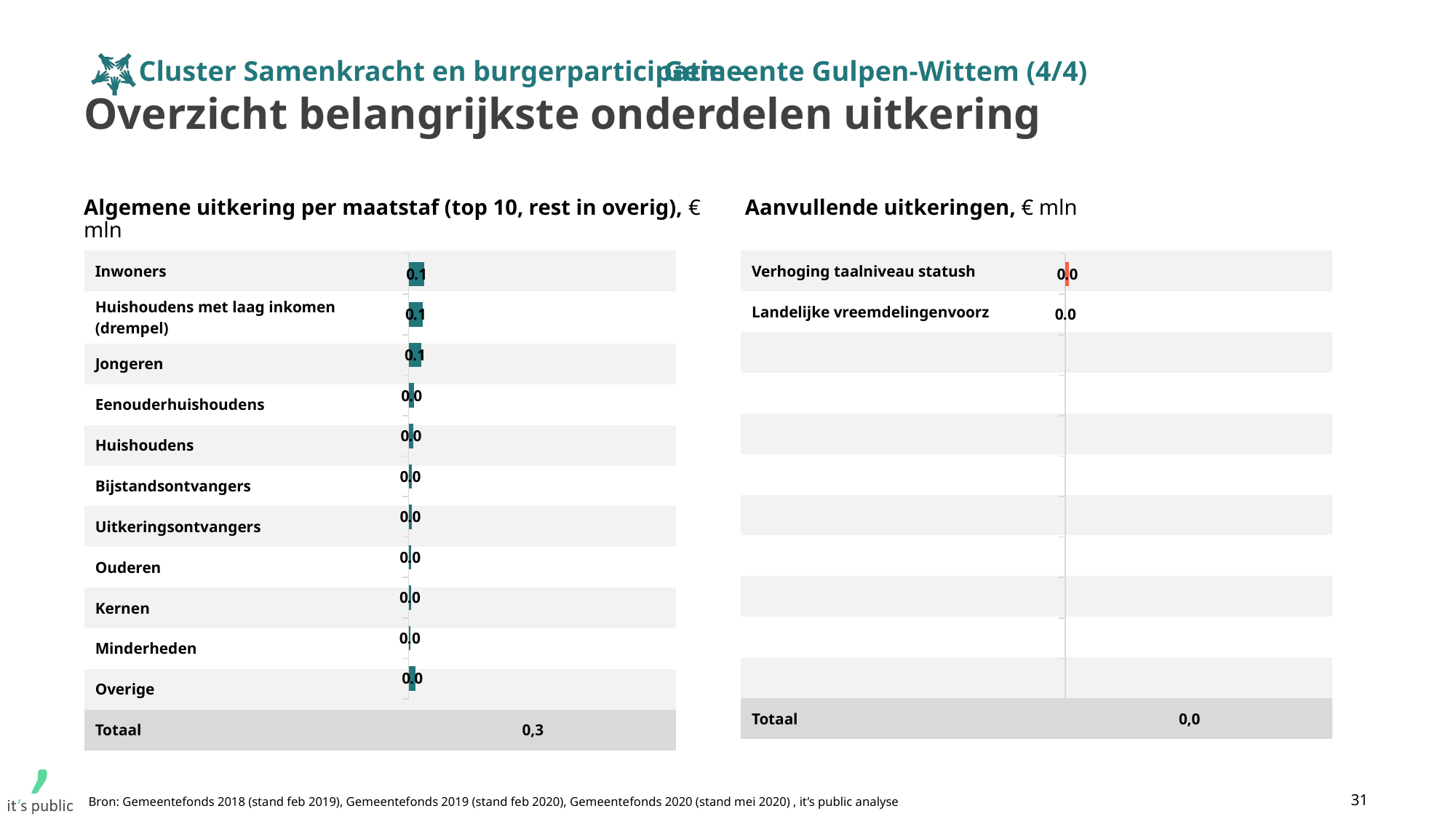
In the chart 'Aanvullende uitkeringen', what is the value for Verhoging taalniveau statush? 0,0 In the chart 'Algemene uitkering per maatstaf', what is the value for Ouderen? 0,0 In the chart 'Algemene uitkering per maatstaf', what is the value for Huishoudens met laag inkomen (drempel)? 0,1 In the chart 'Aanvullende uitkeringen', what is the Totaal shown? 0,0 In the chart 'Aanvullende uitkeringen', how many categories have labels? 2 What kind of chart is 'Algemene uitkering per maatstaf'? Bar chart In the chart 'Algemene uitkering per maatstaf', what is the value for Jongeren? 0,1 In the chart 'Aanvullende uitkeringen', what is the value for Landelijke vreemdelingenvoorz? 0,0 In the chart 'Algemene uitkering per maatstaf', what is the difference between the values for Inwoners and Kernen? 0,1 In the chart 'Algemene uitkering per maatstaf', what is the Totaal shown? 0,3 In the chart 'Algemene uitkering per maatstaf', how many categories are plotted (excluding the Totaal row)? 11 In the chart 'Algemene uitkering per maatstaf', what is the value for Inwoners? 0,1